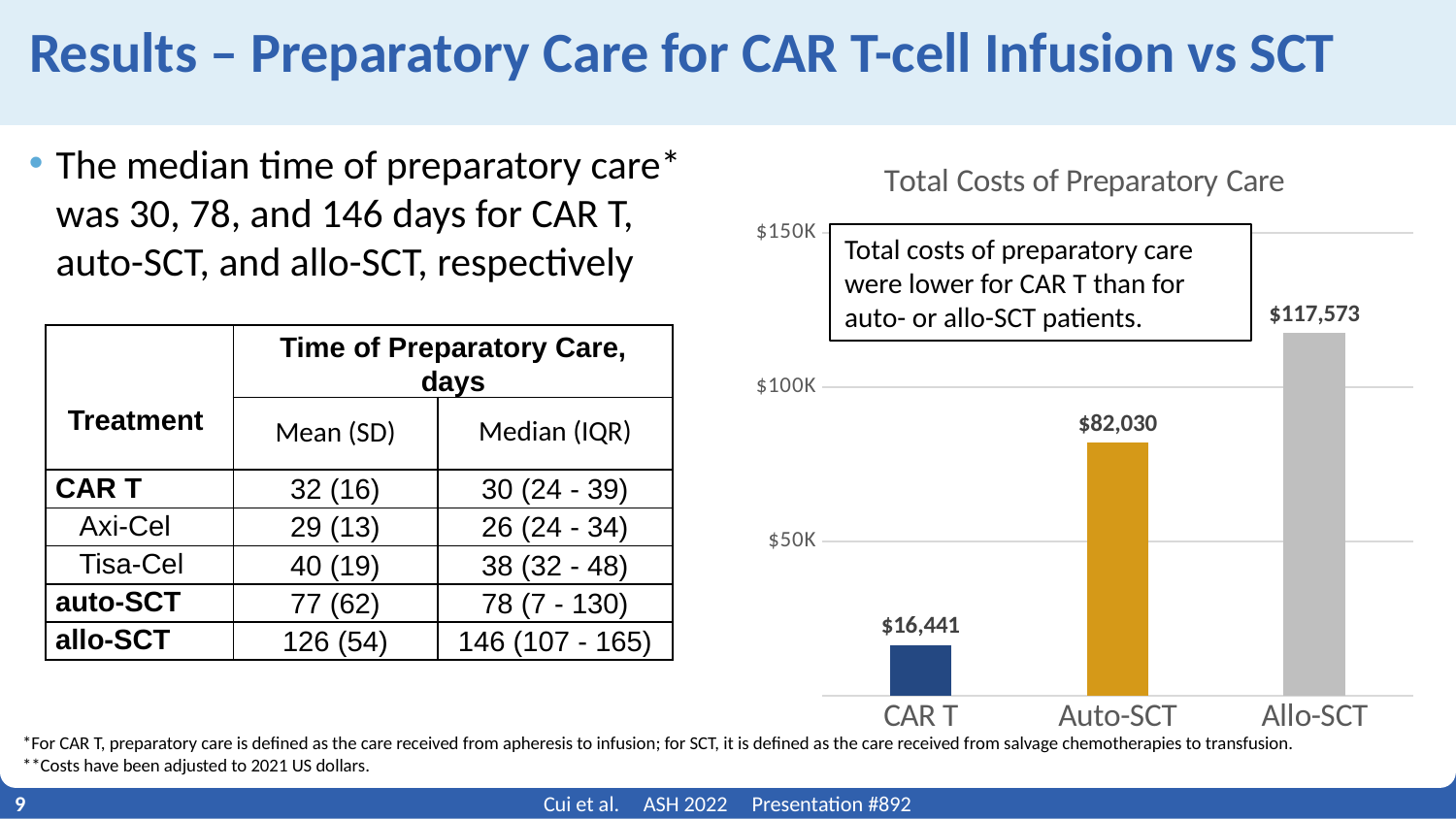
What is the total cost of preparatory care for Auto-SCT? $82,030 What is the difference in total preparatory care cost between Allo-SCT and Auto-SCT? $35,543 Which treatment has the lowest total cost of preparatory care? CAR T What is the total cost of preparatory care for CAR T? $16,441 What is the title of the chart? Total Costs of Preparatory Care What type of chart is used to show total costs of preparatory care? Bar chart Which treatment has the highest total cost of preparatory care? Allo-SCT Is the total cost of preparatory care for Allo-SCT greater or less than $100K? greater Which has a larger total cost of preparatory care, CAR T or Auto-SCT? Auto-SCT What is the difference in total preparatory care cost between Auto-SCT and CAR T? $65,589 How many treatment categories are shown in the chart? 3 What is the total cost of preparatory care for Allo-SCT? $117,573